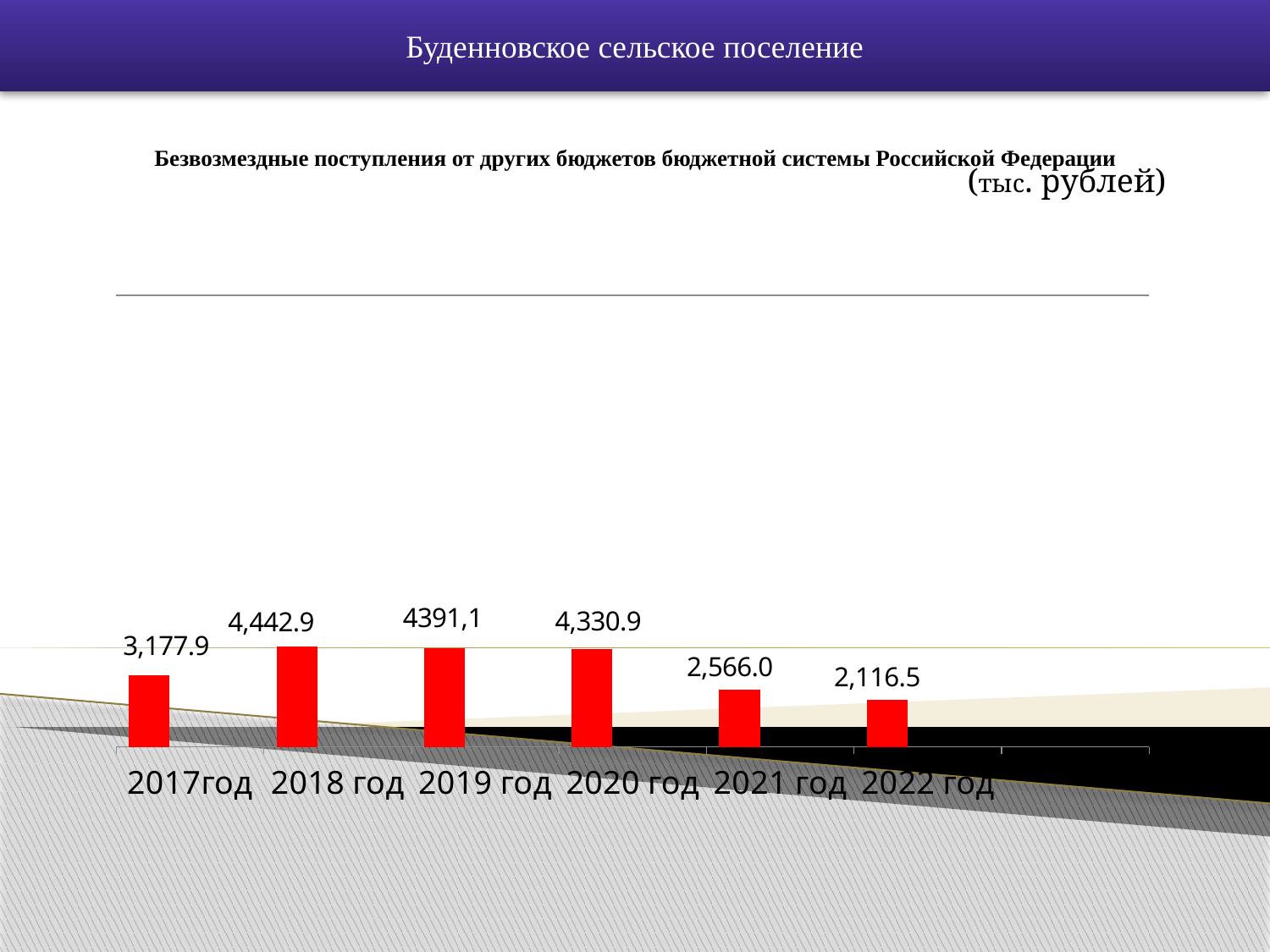
What is the difference between the values for 2018 год and 2017год? 1,265.0 Which is larger, the value for 2020 год or the value for 2021 год? 2020 год Which year has the highest value? 2018 год What kind of chart is shown on the slide? bar chart What is the value for 2021 год? 2,566.0 What is the difference between the values for 2021 год and 2022 год? 449.5 Which year has the lowest value? 2022 год What colour are the bars in the chart? red What is the value for 2017год? 3,177.9 What is the value for 2018 год? 4,442.9 Do the values rise or fall from 2020 год to 2022 год? fall How many years are shown on the chart? 6